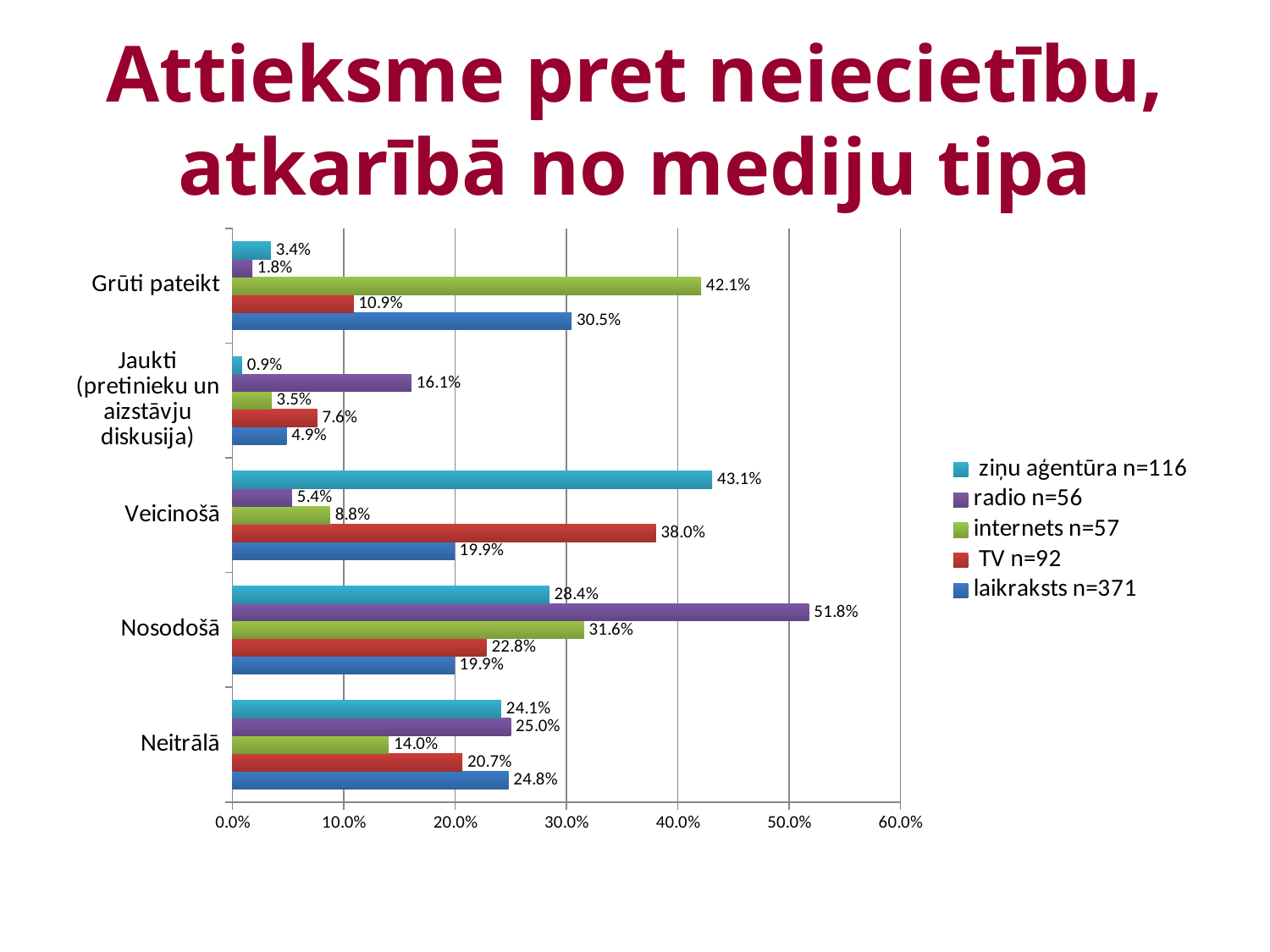
What type of chart is shown on the slide? bar chart What is the difference between the radio n=56 and laikraksts n=371 values in the Nosodošā category? 31.9% What is the value for laikraksts n=371 in the Neitrālā category? 24.8% How many series does the legend list? 5 What is the title of the chart slide? Attieksme pret neiecietību, atkarībā no mediju tipa How many categories are shown on the vertical axis? 5 Which series has the highest value in the Veicinošā category? ziņu aģentūra n=116 What is the value for TV n=92 in the Veicinošā category? 38.0% What is the value for internets n=57 in the Grūti pateikt category? 42.1% In the Grūti pateikt category, which is larger: the value for laikraksts n=371 or the value for TV n=92? laikraksts n=371 What is the value for radio n=56 in the Nosodošā category? 51.8% Which series has the lowest value in the Jaukti (pretinieku un aizstāvju diskusija) category? ziņu aģentūra n=116